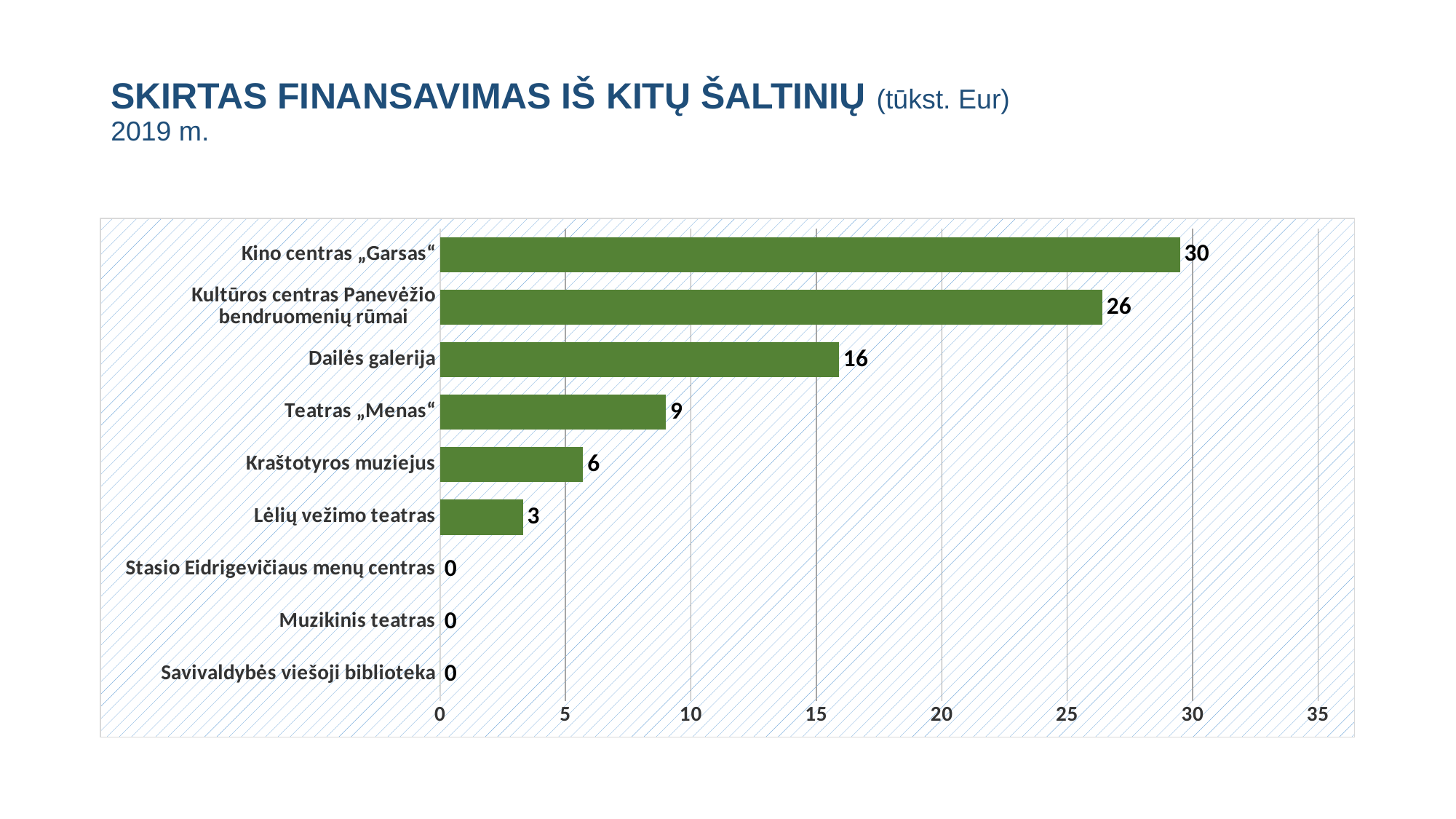
What kind of chart is shown on the slide? Bar chart What is the value for Kino centras „Garsas“? 30 Which is larger, the value for Teatras „Menas“ or the value for Lėlių vežimo teatras? Teatras „Menas“ What is the value for Dailės galerija? 16 Which category has the highest value? Kino centras „Garsas“ How many categories have a value of 0? 3 How many categories are shown in the chart? 9 What is the difference between the values for Kino centras „Garsas“ and Kultūros centras Panevėžio bendruomenių rūmai? 4 What is the value for Muzikinis teatras? 0 What is the difference between the values for Dailės galerija and Teatras „Menas“? 7 What is the title of the slide? SKIRTAS FINANSAVIMAS IŠ KITŲ ŠALTINIŲ (tūkst. Eur) 2019 m. What is the value for Kraštotyros muziejus? 6